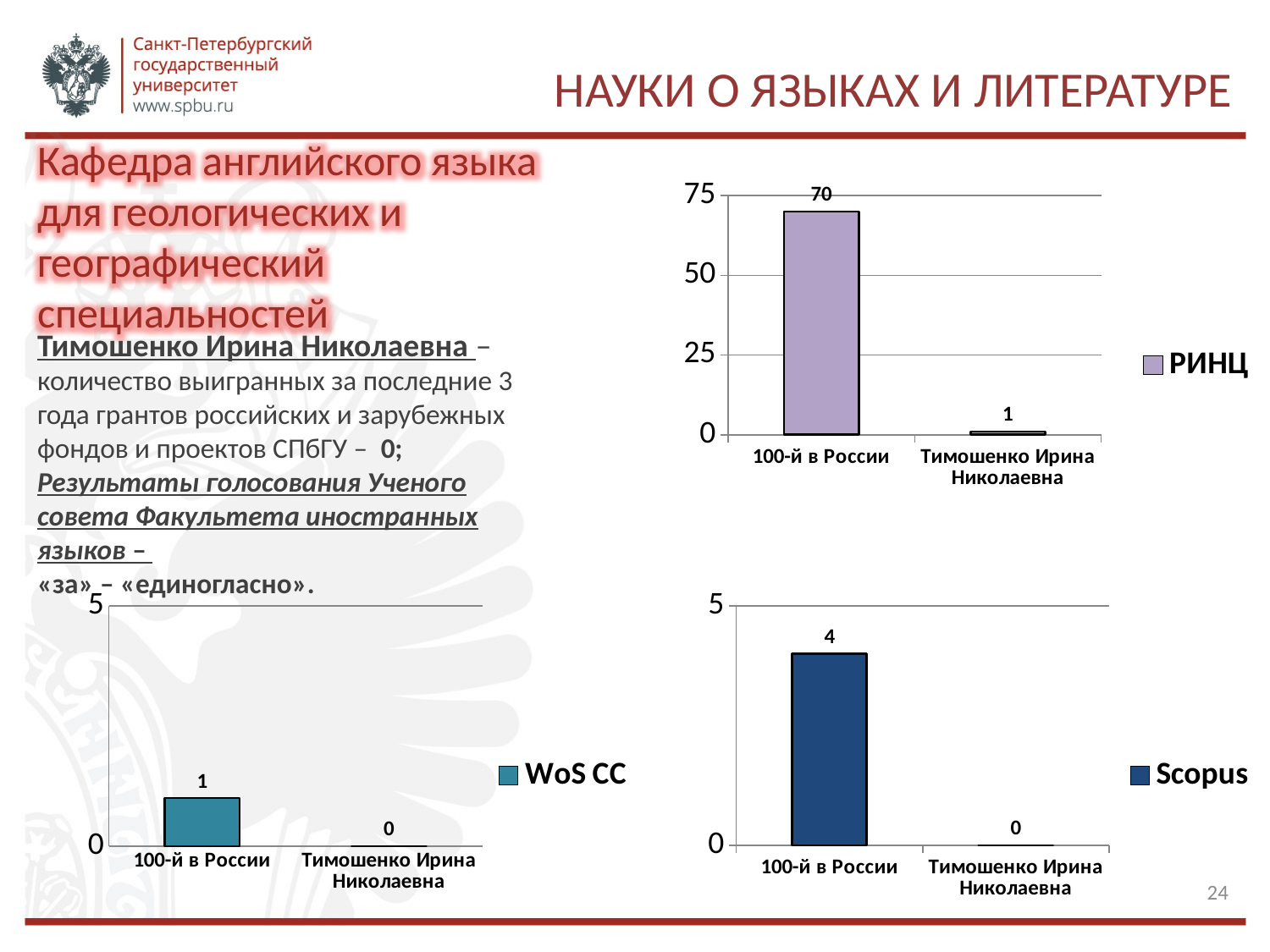
In the WoS CC chart (bottom left), what is the value for Тимошенко Ирина Николаевна? 0 In the WoS CC chart (bottom left), what is the value for 100-й в России? 1 What type of chart is the Scopus chart (bottom right)? Bar chart In the Scopus chart (bottom right), which category has the lowest value? Тимошенко Ирина Николаевна In the РИНЦ chart (top right), what is the difference between the values for 100-й в России and Тимошенко Ирина Николаевна? 69 In the РИНЦ chart (top right), which category has the highest value? 100-й в России In the Scopus chart (bottom right), what is the value for 100-й в России? 4 In the РИНЦ chart (top right), what is the value for 100-й в России? 70 In the Scopus chart (bottom right), what is the value for Тимошенко Ирина Николаевна? 0 How many categories are shown in the WoS CC chart (bottom left)? 2 In the РИНЦ chart (top right), what is the value for Тимошенко Ирина Николаевна? 1 In the Scopus chart (bottom right), what is the difference between the values for 100-й в России and Тимошенко Ирина Николаевна? 4